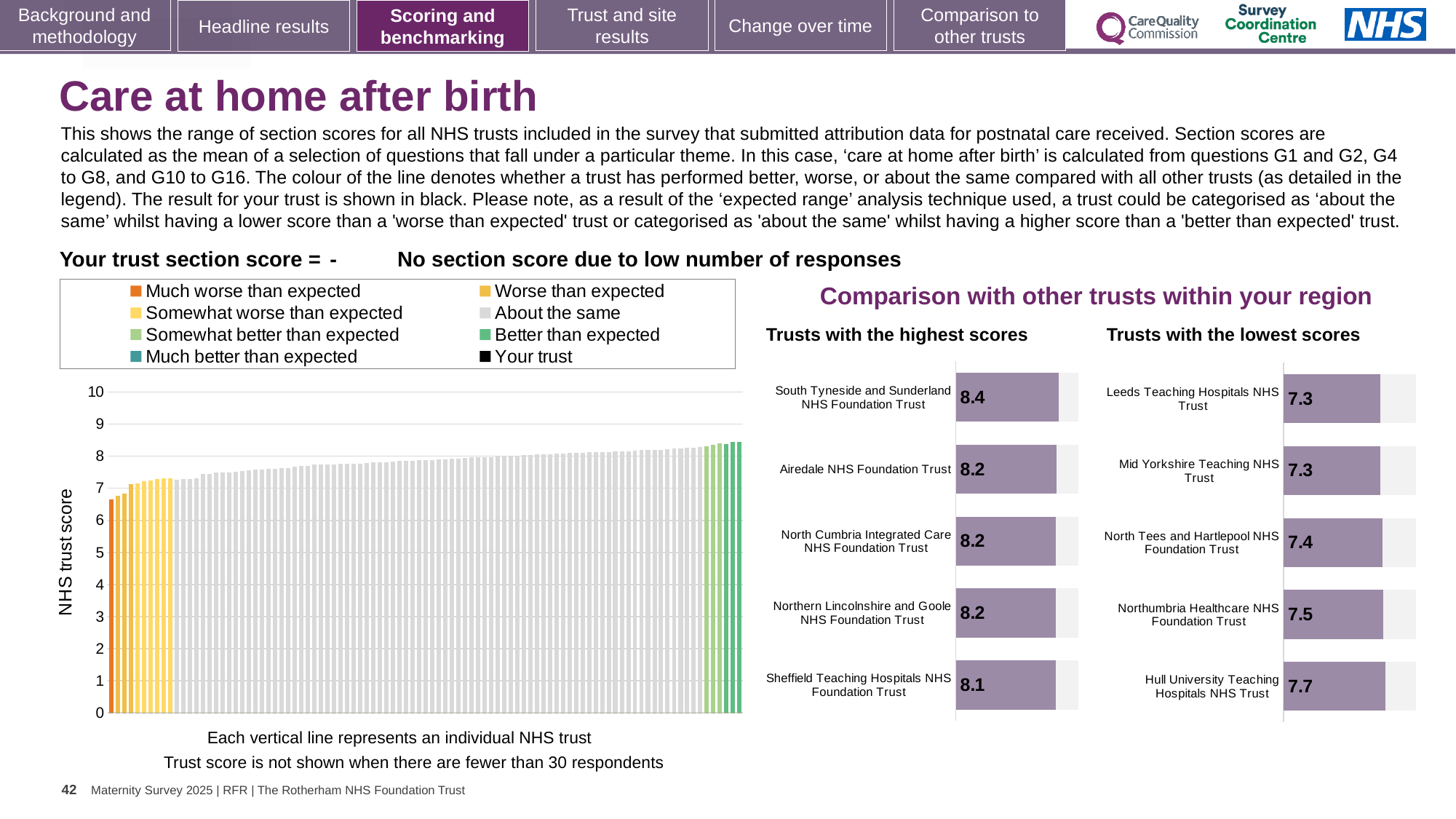
What is the difference between the score for South Tyneside and Sunderland NHS Foundation Trust in the highest scores chart and the score for Leeds Teaching Hospitals NHS Trust in the lowest scores chart? 1.1 In the 'Trusts with the highest scores' chart, which trust has the highest score? South Tyneside and Sunderland NHS Foundation Trust In the 'Trusts with the lowest scores' chart, which trust has the highest score shown? Hull University Teaching Hospitals NHS Trust In the large 'NHS trust score' chart on the left, is the value of the lowest (leftmost) bar greater or less than 7? less In the 'Trusts with the highest scores' chart, what is the score for South Tyneside and Sunderland NHS Foundation Trust? 8.4 In the 'Trusts with the highest scores' chart, what is the score for Sheffield Teaching Hospitals NHS Foundation Trust? 8.1 In the 'Trusts with the lowest scores' chart, what is the score for Hull University Teaching Hospitals NHS Trust? 7.7 What type of chart is the large chart on the left with the 'NHS trust score' axis? bar chart How many trusts are shown in the 'Trusts with the lowest scores' chart? 5 In the large 'NHS trust score' chart on the left, do the bar values rise or fall from left to right? rise Which is larger: the score for Northumbria Healthcare NHS Foundation Trust in the lowest scores chart or the score for Airedale NHS Foundation Trust in the highest scores chart? Airedale NHS Foundation Trust In the 'Trusts with the lowest scores' chart, what is the score for North Tees and Hartlepool NHS Foundation Trust? 7.4